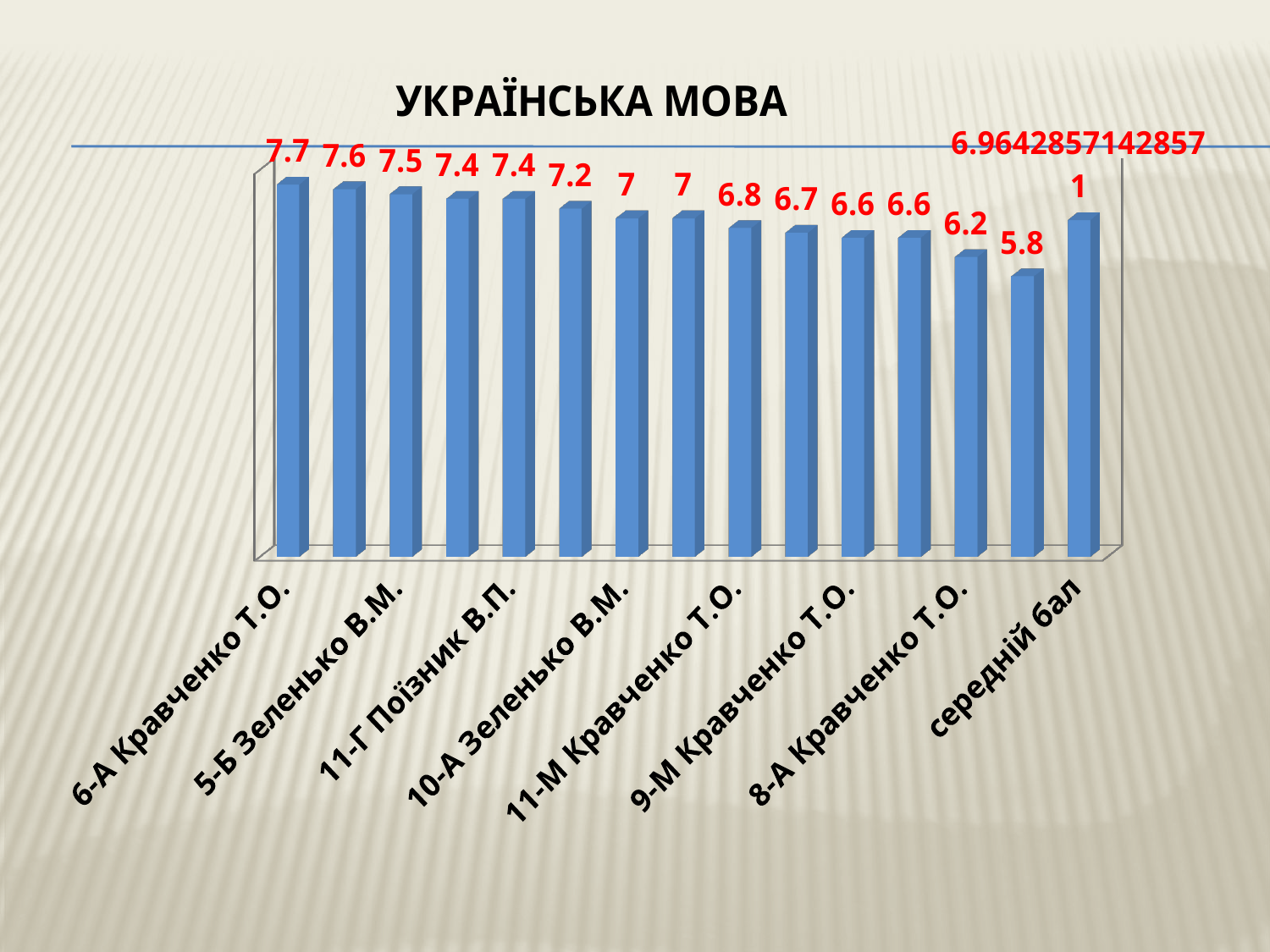
How many bars are plotted on the chart? 15 What is the title of the chart? УКРАЇНСЬКА МОВА Which is larger, the value for 5-Б Зеленько В.М. or the value for 11-М Кравченко Т.О.? 5-Б Зеленько В.М. What is the value for 10-А Зеленько В.М.? 7 What is the value for 6-А Кравченко Т.О.? 7.7 What is the value for 5-Б Зеленько В.М.? 7.5 What is the difference between the values for 6-А Кравченко Т.О. and 8-А Кравченко Т.О.? 1.5 What is the value for 8-А Кравченко Т.О.? 6.2 Which category has the highest value? 6-А Кравченко Т.О. What kind of chart is shown? Bar chart What is the value for 11-Г Поїзник В.П.? 7.4 What is the lowest value shown on the chart? 5.8